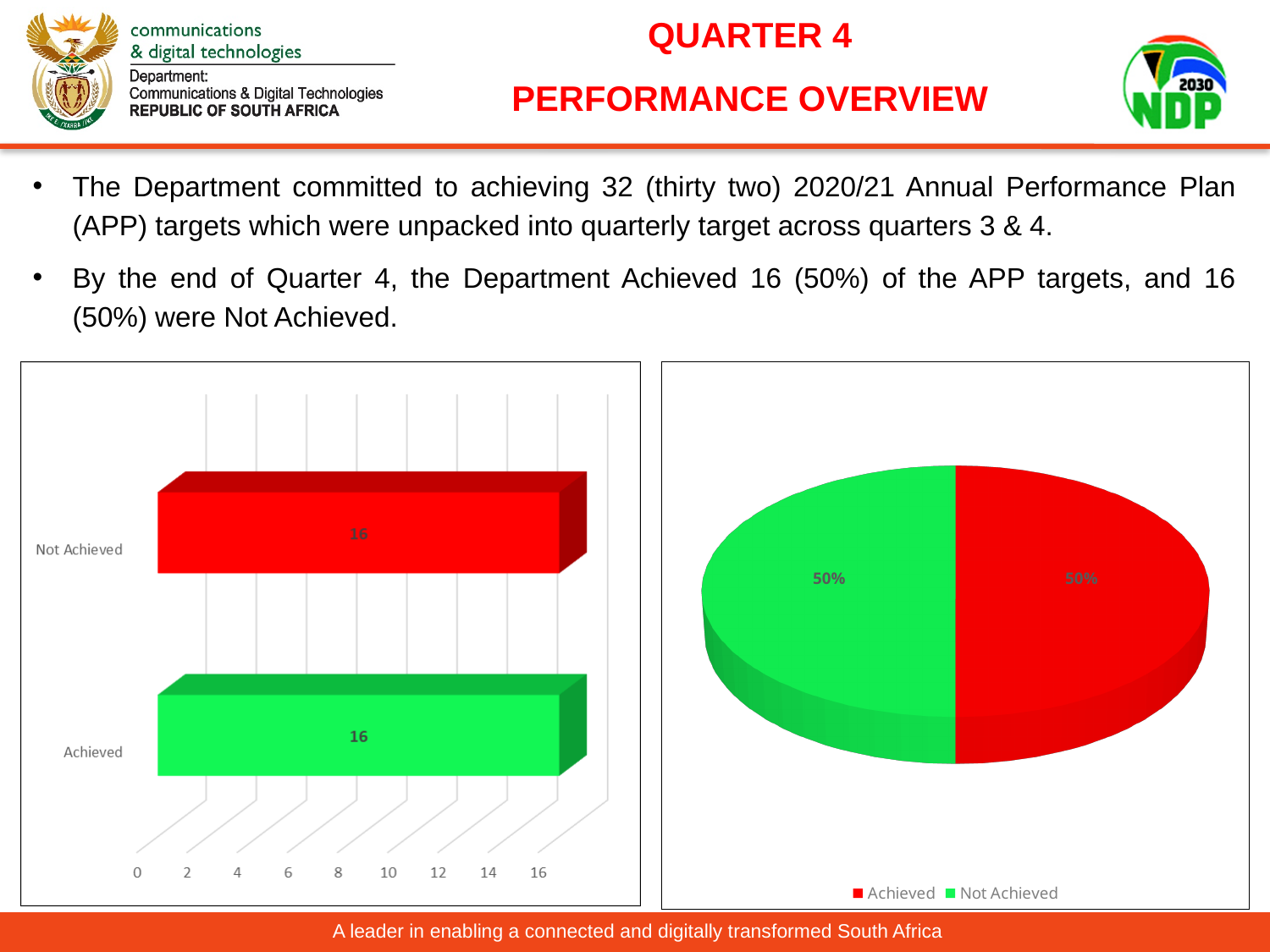
In the bar chart on the left, how many categories are shown? 2 In the bar chart on the left, what is the highest value shown on the axis? 16 In the pie chart on the right, what share is labelled on the Achieved slice? 50% In the bar chart on the left, is the value for Achieved greater or less than 10? greater In the bar chart on the left, what is the value for Achieved? 16 In the pie chart on the right, what share is labelled on the Not Achieved slice? 50% What kind of chart is shown on the left of the slide? Bar chart In the pie chart on the right, what are the two legend entries? Achieved and Not Achieved What kind of chart is shown on the right of the slide? Pie chart In the bar chart on the left, what is the value for Not Achieved? 16 In the pie chart on the right, how many entries does the legend list? 2 In the bar chart on the left, what is the difference between the Not Achieved and Achieved values? 0